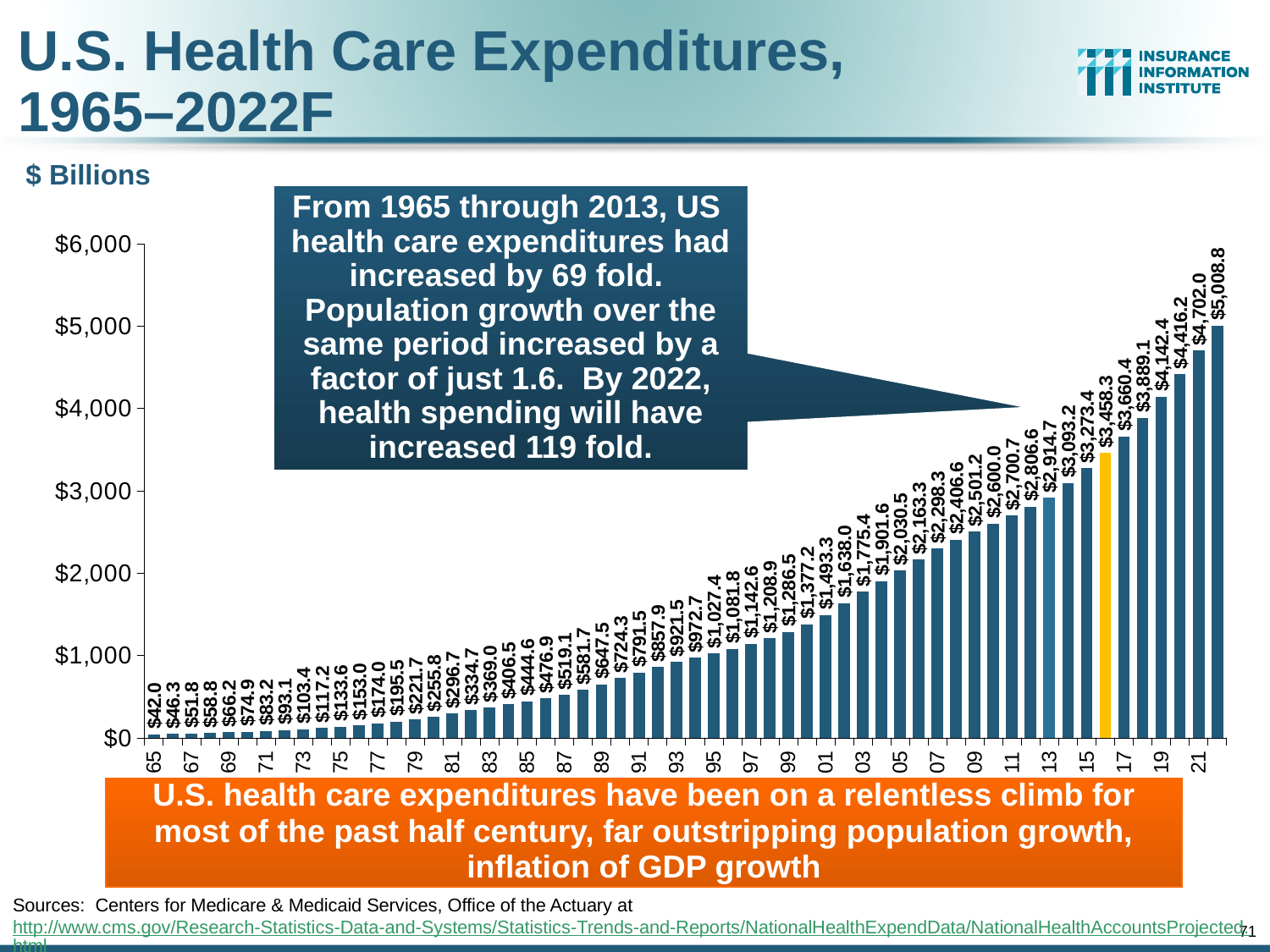
What is the value of U.S. health care expenditures for 2022F? $5,008.8 What is the value of the bar highlighted in orange? $3,458.3 What kind of chart is shown on the slide? bar chart What is the value of U.S. health care expenditures for 1985? $444.6 Which year has the lowest health care expenditures in the chart? 1965 Which year has the highest health care expenditures in the chart? 2022 What is the value of U.S. health care expenditures for 2013? $2,914.7 What is the value of U.S. health care expenditures for 2001? $1,493.3 Do health care expenditures rise or fall from 1965 to 2022 along the x axis? rise What is the value of U.S. health care expenditures for 1965? $42.0 What is the difference between the 2022F value and the 1965 value? $4,966.8 Which is larger, the value for 2015 or the value for 2013? 2015